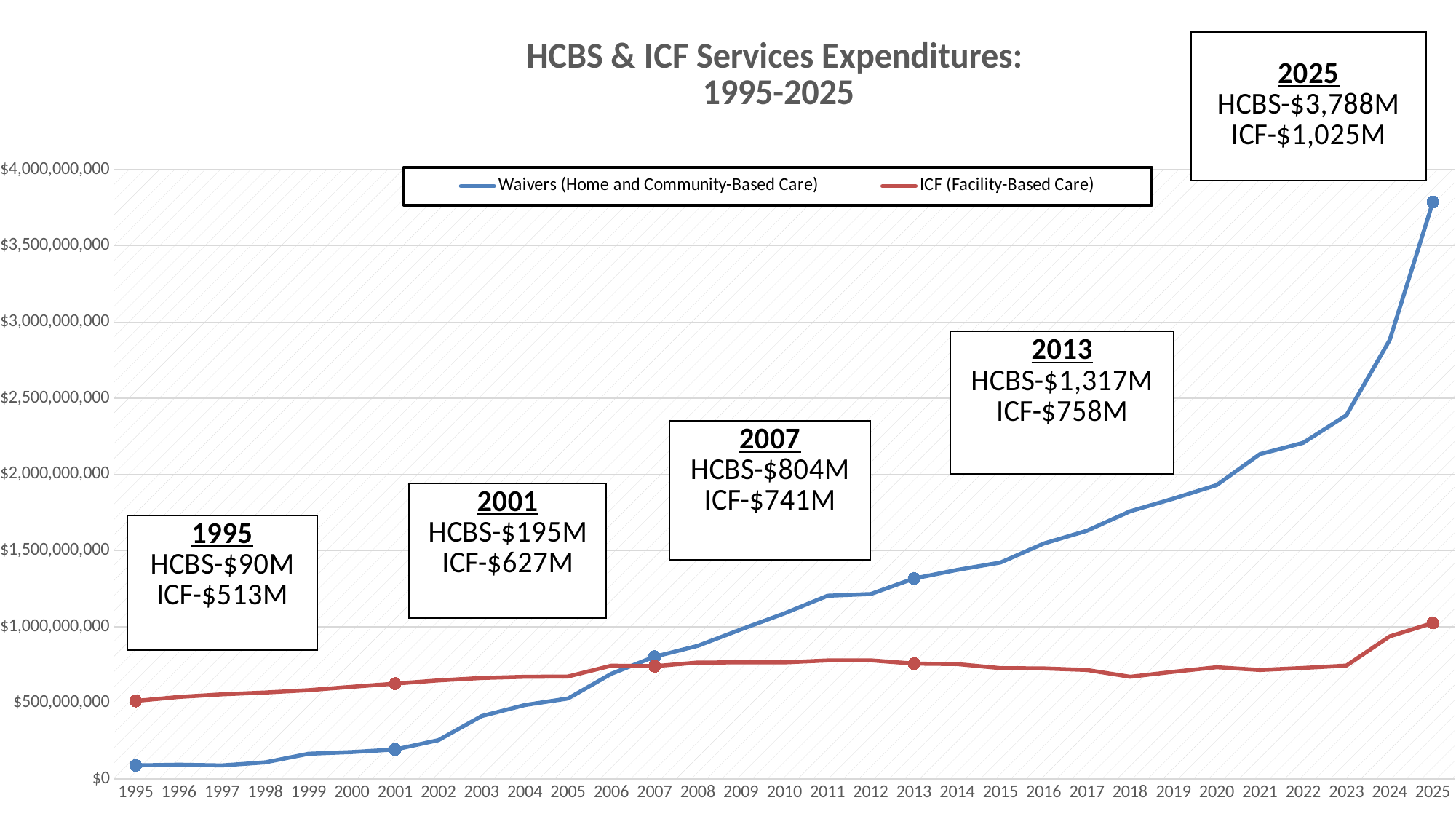
In 2025, which was larger: HCBS or ICF expenditure? HCBS How many series does the legend list? 2 What was the HCBS expenditure in 1995 according to the callout? $90M Is the Waivers (Home and Community-Based Care) value for 2020 greater or less than $1,500,000,000? greater What is the difference between HCBS and ICF expenditures in 2007 according to the callout? $63M What kind of chart is shown on the slide? line chart What was the ICF expenditure in 2013 according to the callout? $758M What was the ICF expenditure in 2001 according to the callout? $627M Does the Waivers (Home and Community-Based Care) line generally rise or fall from 1995 to 2025? rise What is the title of the chart? HCBS & ICF Services Expenditures: 1995-2025 In 1995, which was larger: HCBS or ICF expenditure? ICF What was the HCBS expenditure in 2025 according to the callout? $3,788M